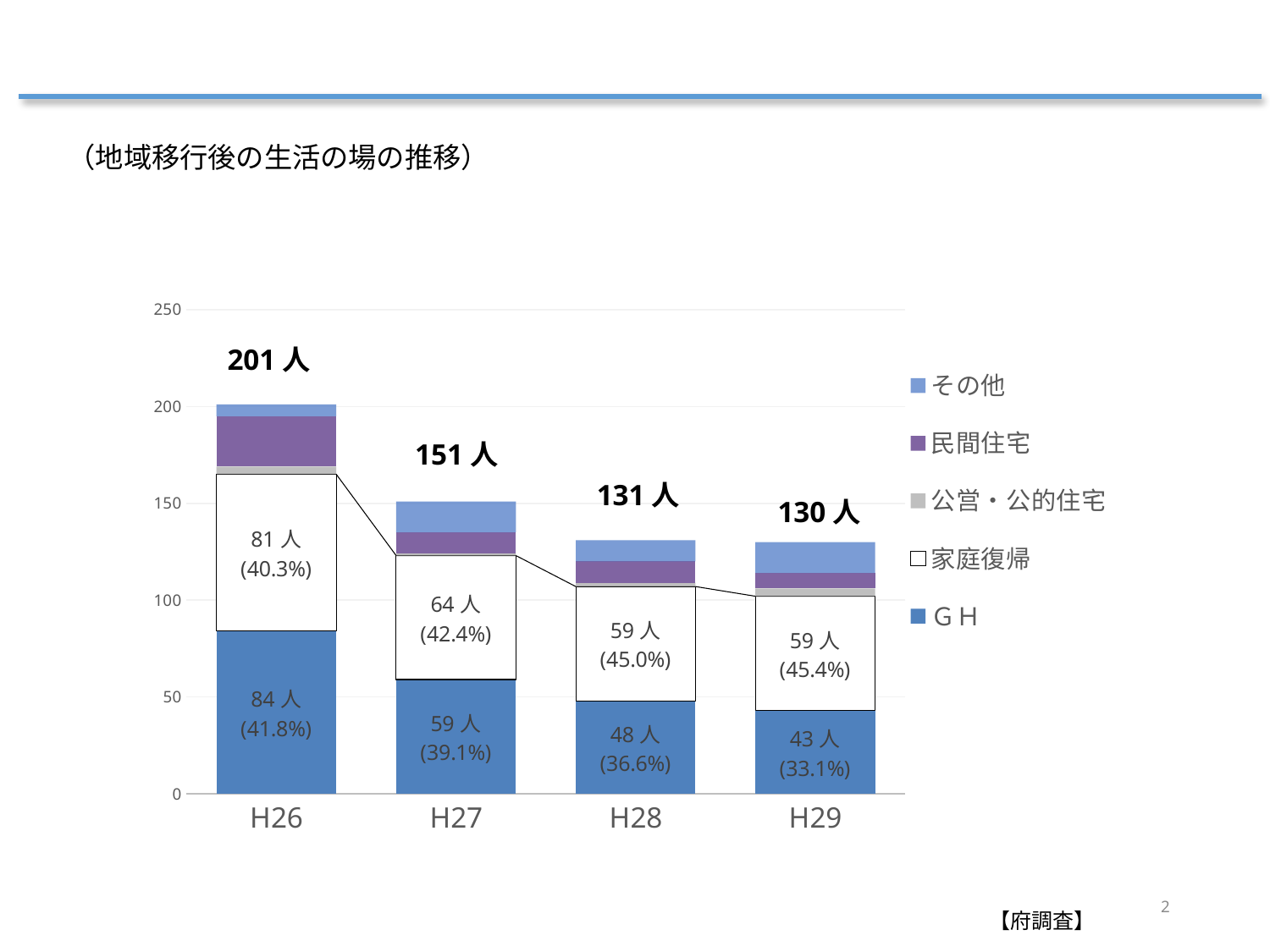
What kind of chart is shown on the slide? stacked bar chart What is the difference between the ＧＨ values for H26 and H29? 41人 Which year has the highest total? H26 Is the value for 家庭復帰 in H26 larger than the value for 家庭復帰 in H27? yes What is the value for ＧＨ in H27? 59人 (39.1%) What is the total for the H29 bar? 130人 How many series does the legend list? 5 What is the total for the H26 bar? 201人 Do the bar totals rise or fall from H26 to H29? fall What is the value for 家庭復帰 in H28? 59人 (45.0%) How many categories are shown on the x axis? 4 Which year has the lowest value for ＧＨ? H29